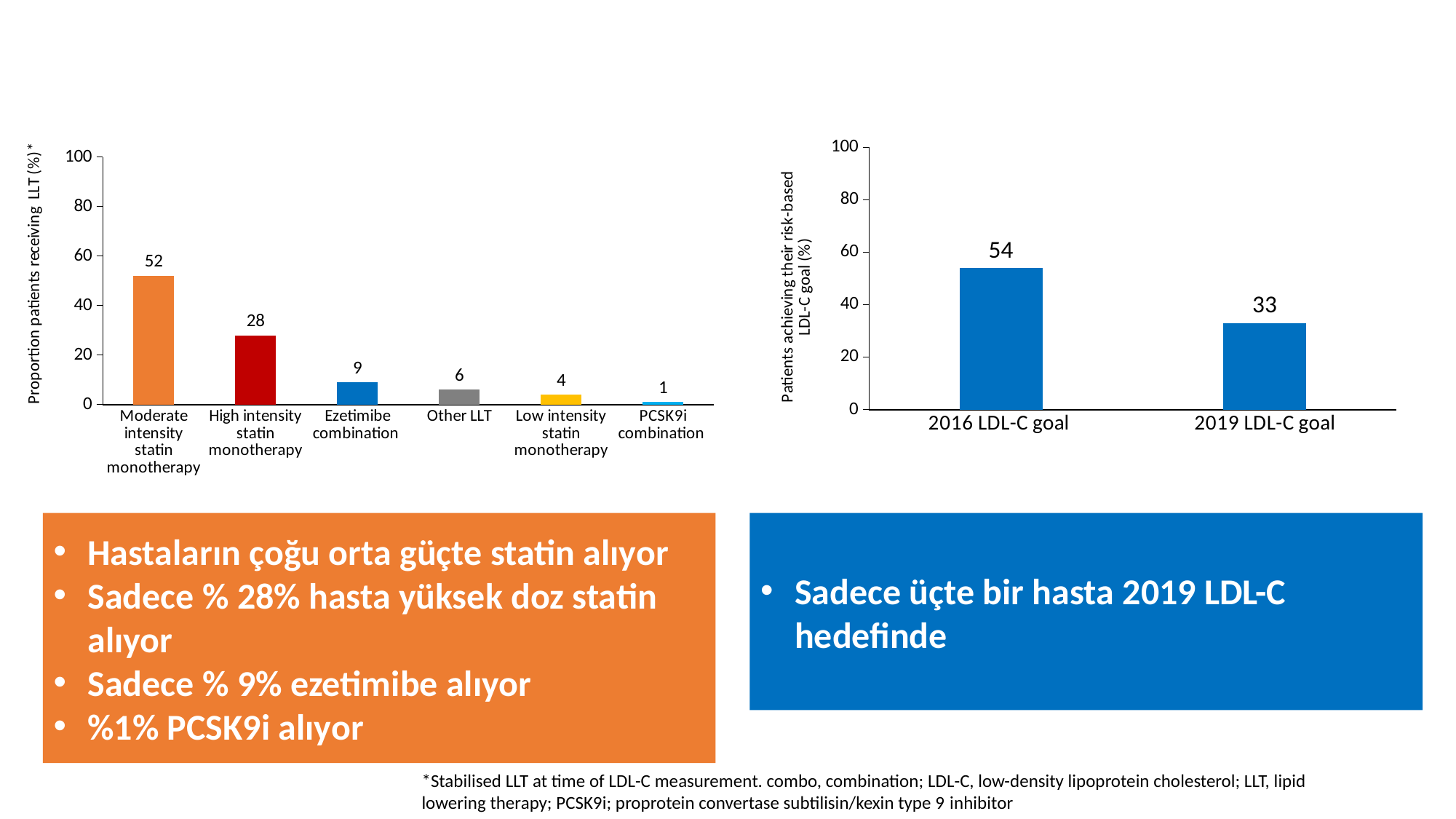
In the left chart, what colour is the bar for High intensity statin monotherapy? red In the left chart (Proportion patients receiving LLT), what is the difference between Moderate intensity statin monotherapy and High intensity statin monotherapy? 24 What kind of chart is the right chart (Patients achieving their risk-based LDL-C goal)? bar chart In the right chart (Patients achieving their risk-based LDL-C goal), what is the difference between the 2016 LDL-C goal and 2019 LDL-C goal values? 21 In the right chart (Patients achieving their risk-based LDL-C goal), what is the value for 2016 LDL-C goal? 54 In the left chart (Proportion patients receiving LLT), which category has the highest value? Moderate intensity statin monotherapy In the left chart (Proportion patients receiving LLT), is the value for Other LLT greater or less than Low intensity statin monotherapy? greater In the right chart (Patients achieving their risk-based LDL-C goal), what is the value for 2019 LDL-C goal? 33 In the left chart (Proportion patients receiving LLT), what is the value for Ezetimibe combination? 9 In the left chart (Proportion patients receiving LLT), how many categories are shown on the x axis? 6 In the left chart (Proportion patients receiving LLT), what is the value for Moderate intensity statin monotherapy? 52 In the left chart (Proportion patients receiving LLT), which category has the lowest value? PCSK9i combination